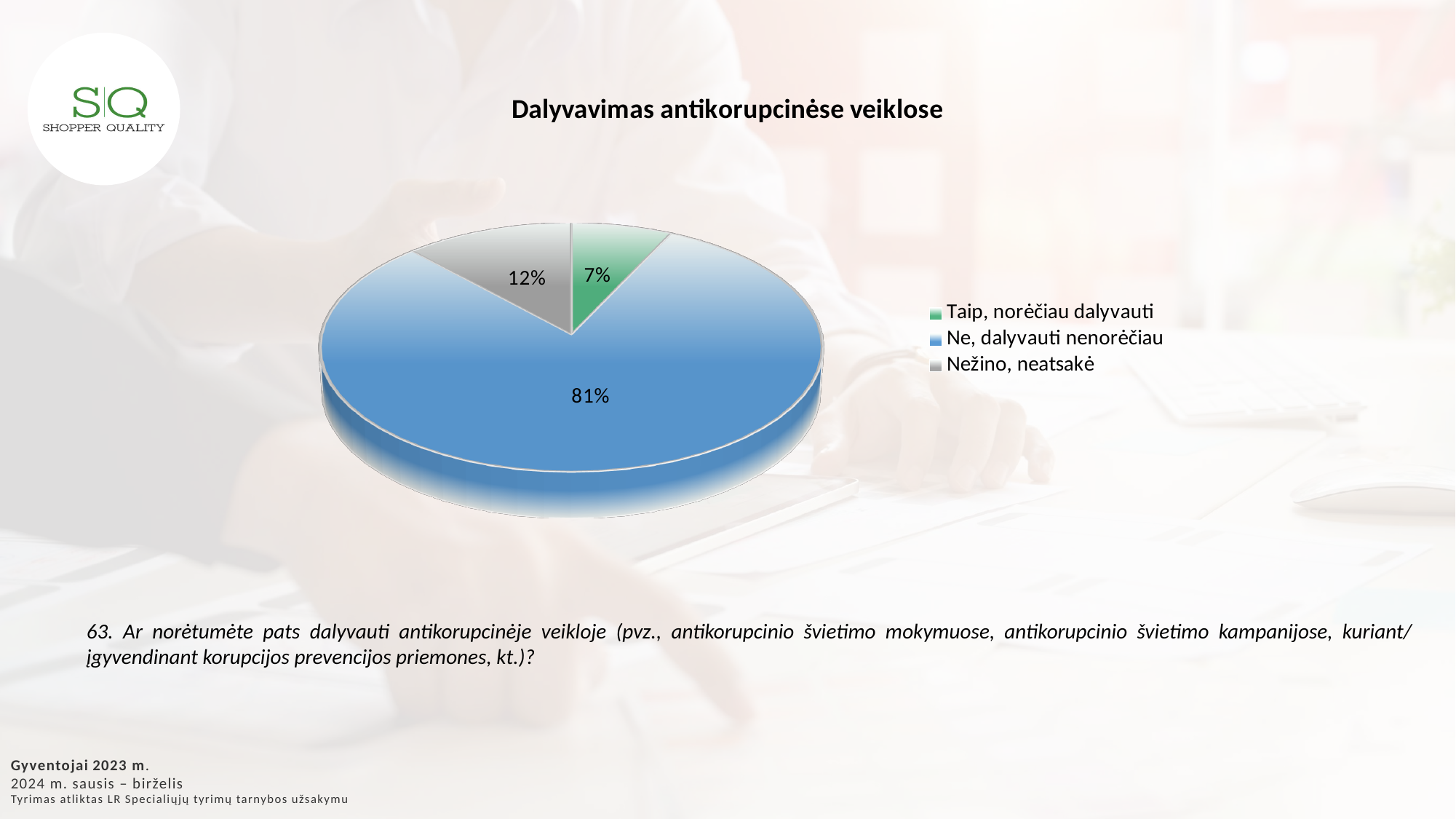
What is the difference between the "Nežino, neatsakė" share and the "Taip, norėčiau dalyvauti" share? 5% What is the chart's title? Dalyvavimas antikorupcinėse veiklose What colour is the slice for "Taip, norėčiau dalyvauti"? green What share of the pie is labelled "Taip, norėčiau dalyvauti"? 7% Which category has the smallest slice of the pie? Taip, norėčiau dalyvauti What share of the pie is labelled "Nežino, neatsakė"? 12% What is the difference between the "Ne, dalyvauti nenorėčiau" share and the "Nežino, neatsakė" share? 69% How many slices does the pie chart have? 3 Which is larger: the share for "Nežino, neatsakė" or the share for "Taip, norėčiau dalyvauti"? Nežino, neatsakė What share of the pie is labelled "Ne, dalyvauti nenorėčiau"? 81% What type of chart is shown on the slide? pie chart Which category has the largest slice of the pie? Ne, dalyvauti nenorėčiau